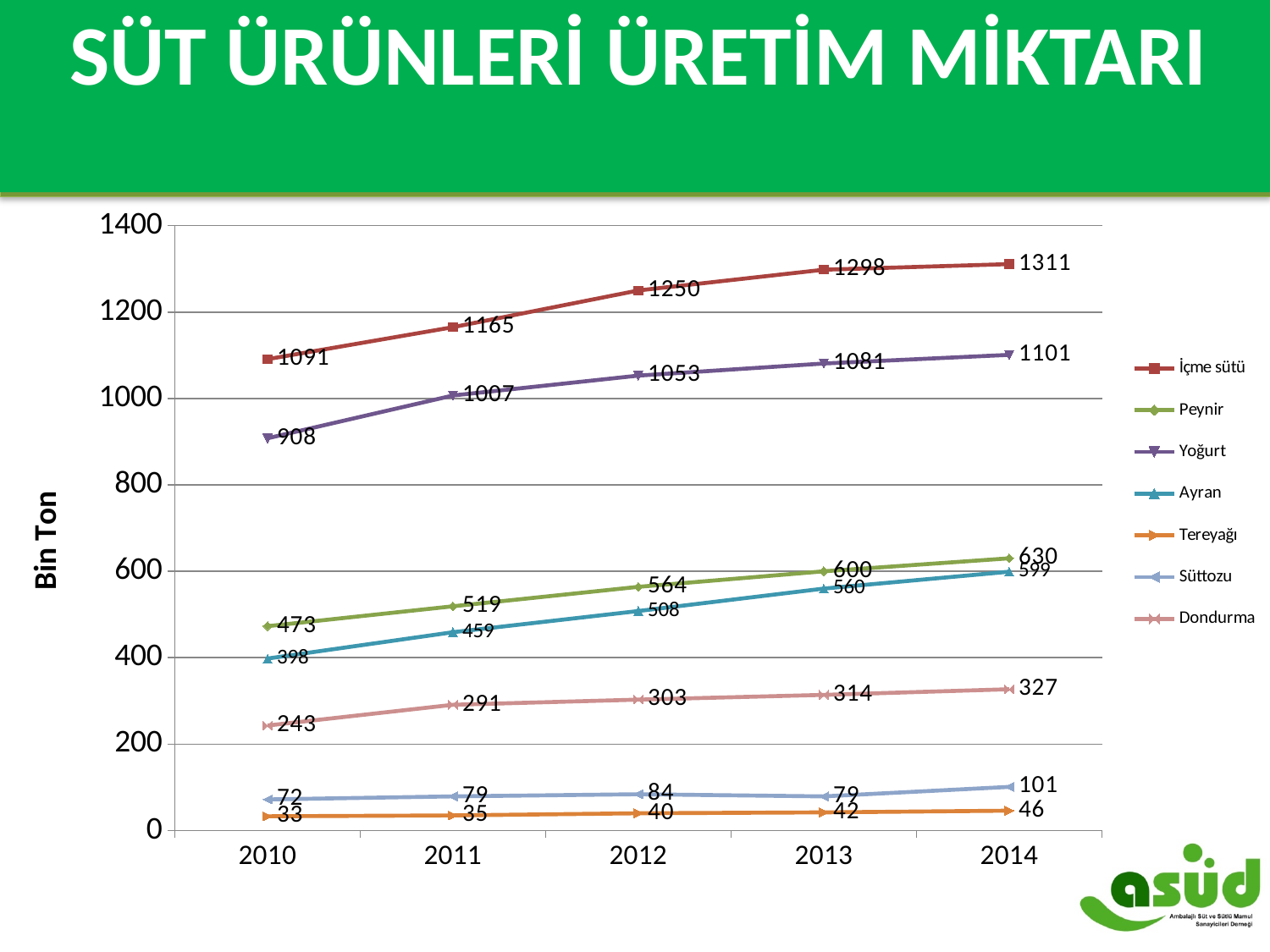
Which series has the highest value in 2014? İçme sütü Does the value for İçme sütü rise or fall from 2010 to 2014? rise What is the label of the y axis? Bin Ton What type of chart is shown on the slide? line chart What is the difference between the Peynir values in 2014 and 2010? 157 How many years are shown on the x axis? 5 How many series does the legend list? 7 Which series has the lowest value in 2010? Tereyağı Which is larger in 2012, Peynir or Ayran? Peynir What is the value for Ayran in 2013? 560 What is the value for Yoğurt in 2011? 1007 What is the value for İçme sütü in 2014? 1311